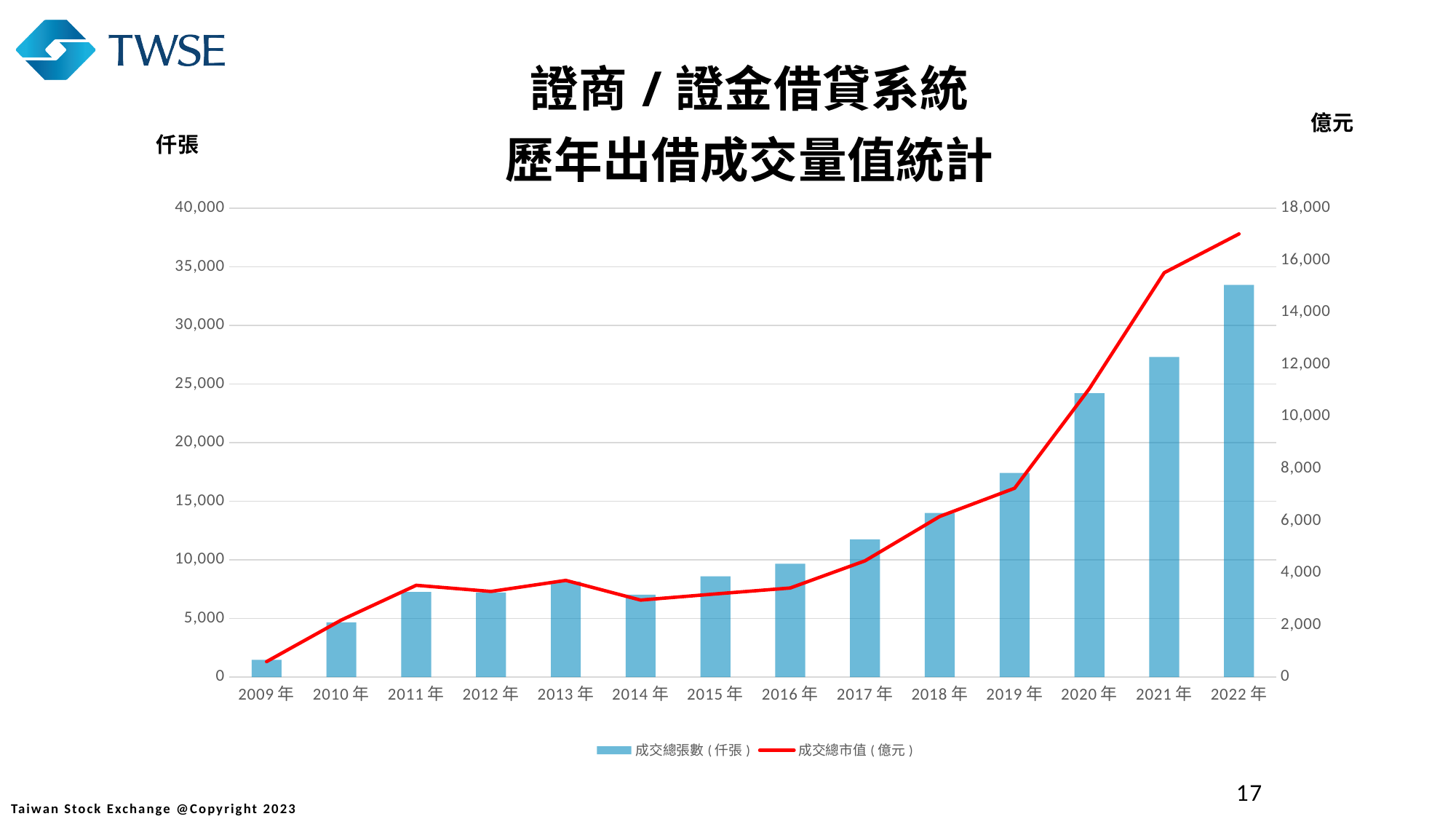
Is the 成交總張數 bar for 2020 年 greater or less than 20,000? greater What unit label is shown above the left axis of the chart? 仟張 How many series does the chart legend list? 2 Which year has the shortest bar for 成交總張數 (仟張)? 2009 年 How many years are shown on the x axis of the chart? 14 Does the 成交總市值 (億元) line generally rise or fall from 2009 年 to 2022 年? rise What kind of chart is shown on the slide? A bar chart combined with a line chart Is the 成交總市值 (億元) value for 2022 年 greater or less than 16,000 on the right axis? greater Which year has the tallest bar for 成交總張數 (仟張)? 2022 年 Is the 成交總張數 bar for 2014 年 greater or less than 10,000? less Which year has the larger 成交總張數 bar, 2019 年 or 2021 年? 2021 年